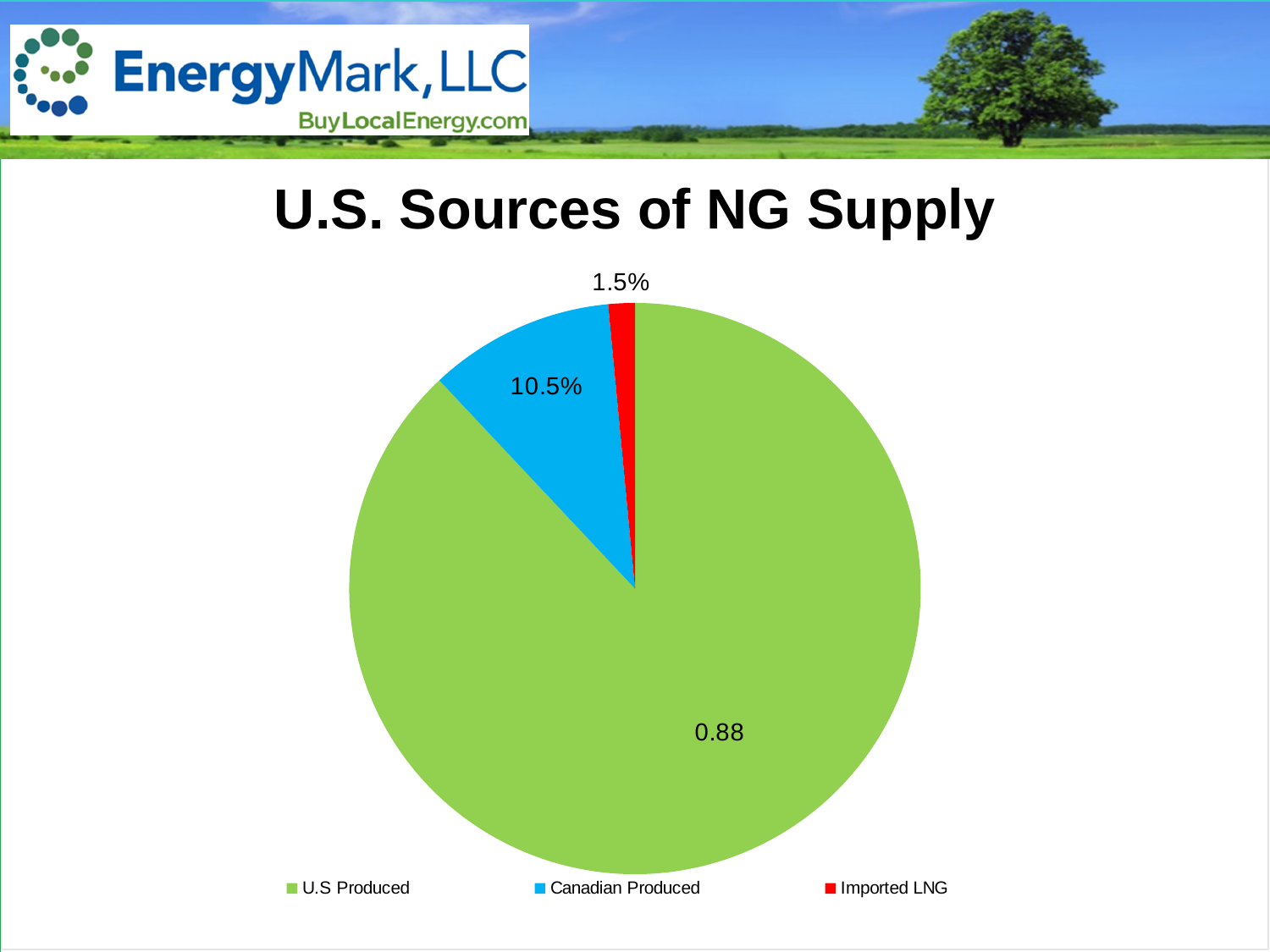
What is the difference between the Canadian Produced share and the Imported LNG share? 9% What value is labelled on the U.S Produced slice? 0.88 What kind of chart is shown on the slide? pie chart What share of the pie is Imported LNG? 1.5% What share of the pie is Canadian Produced? 10.5% Which is larger, the Canadian Produced slice or the Imported LNG slice? Canadian Produced Which source has the smallest slice of the pie? Imported LNG How many entries does the legend list? 3 What colour is the Imported LNG slice? red How many slices does the pie chart have? 3 What is the title of the chart? U.S. Sources of NG Supply Which source has the largest slice of the pie? U.S Produced